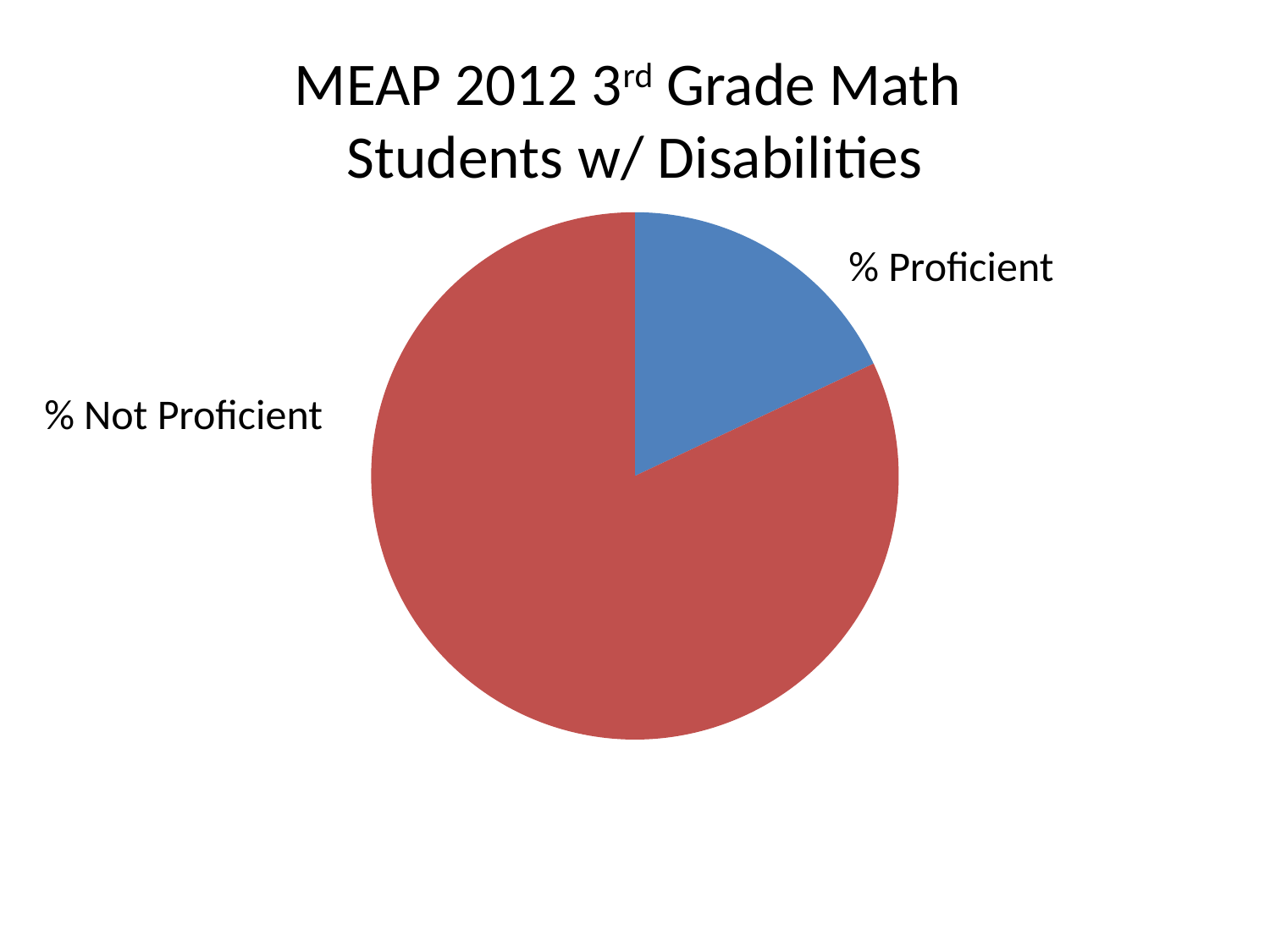
What colour is the % Proficient slice of the pie chart? blue What is the title of the chart? MEAP 2012 3rd Grade Math Students w/ Disabilities What kind of chart is shown on the slide? pie chart Which slice of the pie chart is the largest? % Not Proficient Which slice of the pie chart is the smallest? % Proficient Which is larger in the pie chart, % Proficient or % Not Proficient? % Not Proficient How many slices does the pie chart have? 2